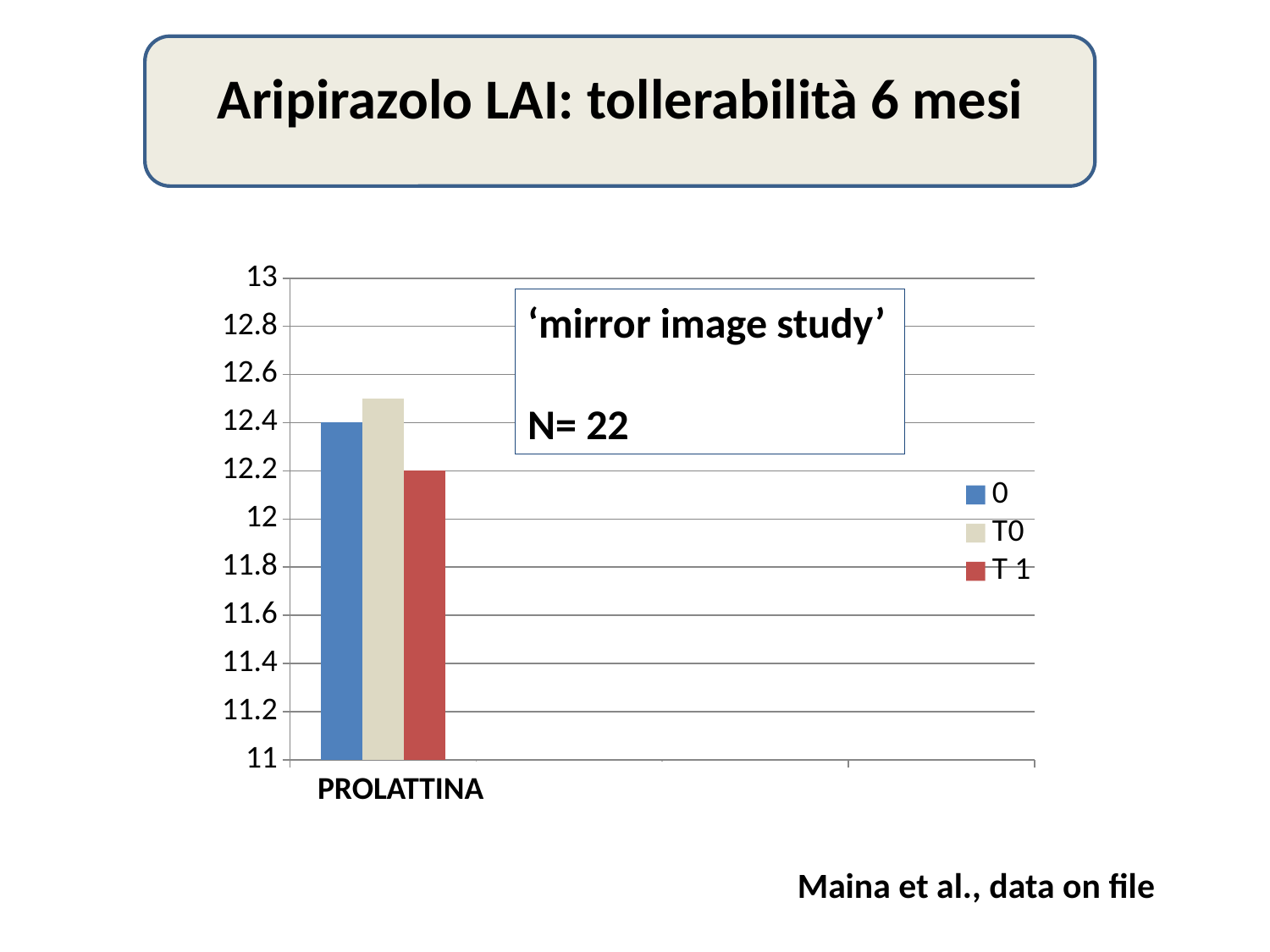
How many series does the legend list? 3 What kind of chart is shown on the slide? bar chart What colour is the bar for the series "T 1"? red Which series has the lowest value for PROLATTINA? T 1 What is the difference between the values of series "0" and series "T 1" for PROLATTINA? 0.2 Which series has the highest value for PROLATTINA? T0 What is the value of the series "0" for PROLATTINA? 12.4 What is the value of the series "T 1" for PROLATTINA? 12.2 Is the value of the series "T0" for PROLATTINA greater or less than 12.4? greater How many categories are shown on the x axis? 1 What is the category label shown on the x axis? PROLATTINA Which is larger for PROLATTINA, the value of series "0" or series "T 1"? 0